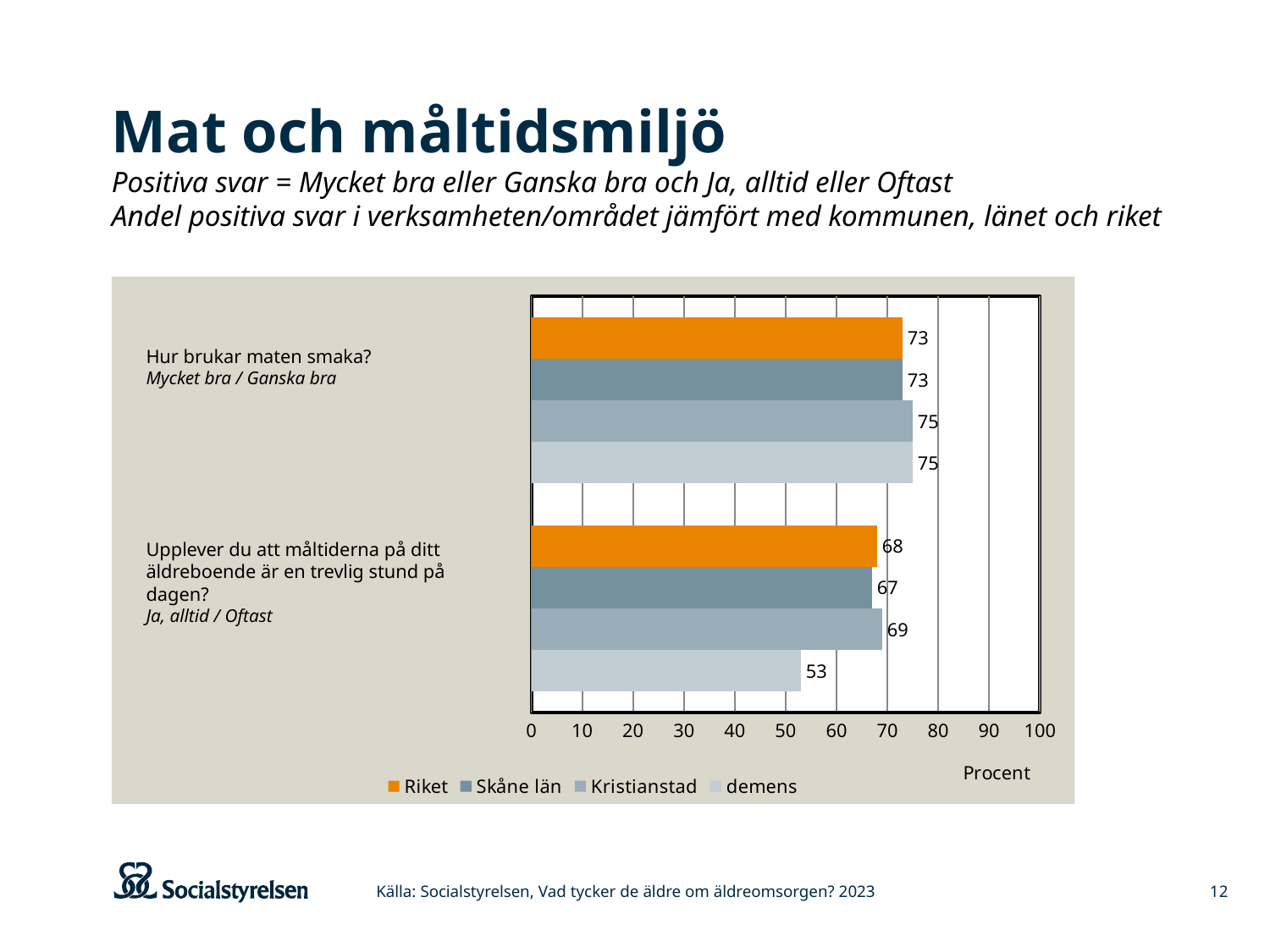
How many question categories are plotted on the chart? 2 What kind of chart is shown on the slide? bar chart Which series has the lowest value for 'Upplever du att måltiderna på ditt äldreboende är en trevlig stund på dagen?' demens What is the difference between the Kristianstad and Riket values for 'Hur brukar maten smaka?' 2 What is the value for Skåne län for 'Upplever du att måltiderna på ditt äldreboende är en trevlig stund på dagen?' 67 What is the value for demens for 'Upplever du att måltiderna på ditt äldreboende är en trevlig stund på dagen?' 53 What unit label is shown under the x axis? Procent What is the difference between the Kristianstad and demens values for 'Upplever du att måltiderna på ditt äldreboende är en trevlig stund på dagen?' 16 How many series does the legend list? 4 What is the value for Riket for 'Hur brukar maten smaka?' 73 Which is larger for 'Upplever du att måltiderna på ditt äldreboende är en trevlig stund på dagen?': Riket or demens? Riket What is the value for Kristianstad for 'Hur brukar maten smaka?' 75